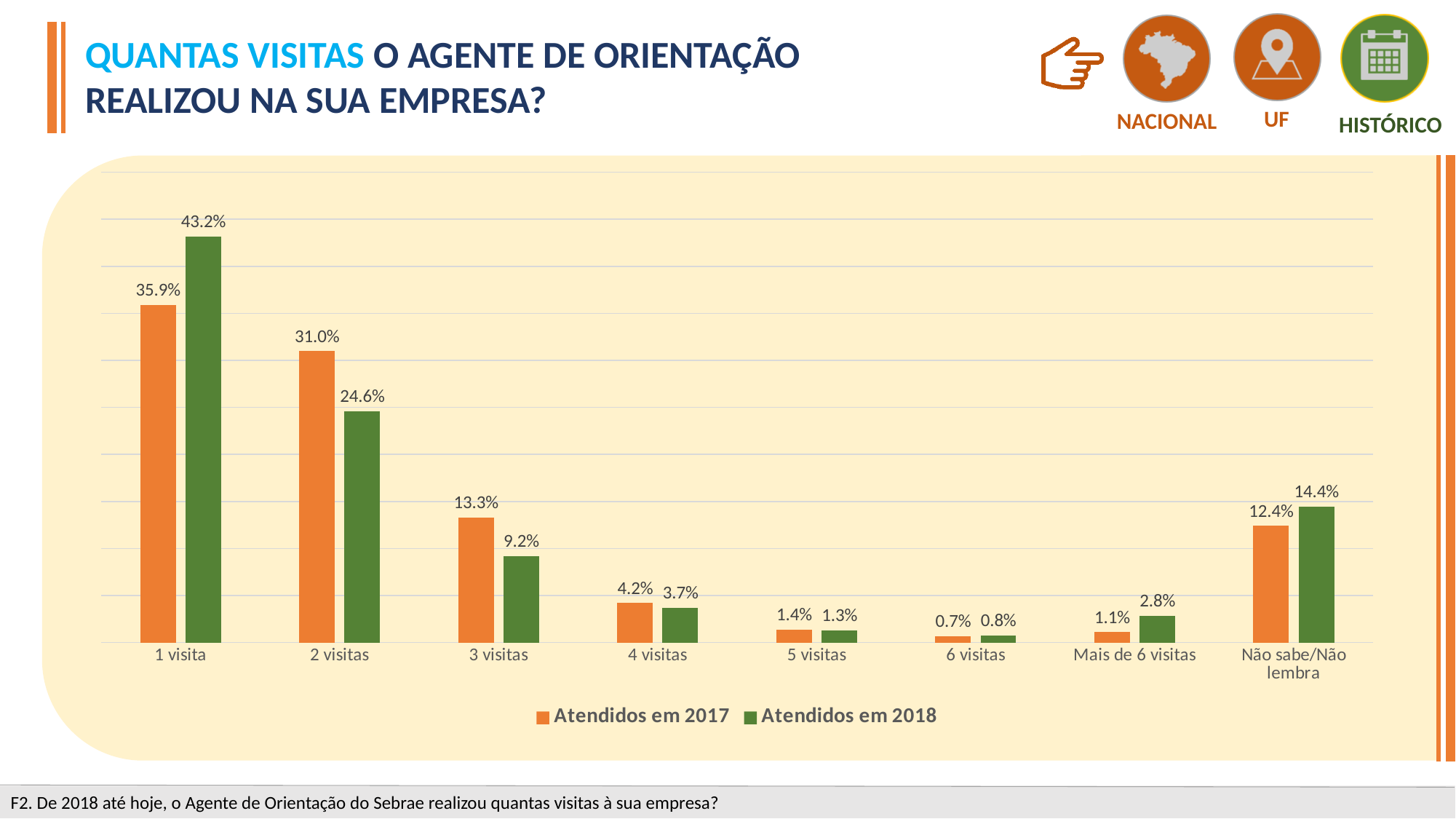
What is the value for 'Mais de 6 visitas' in the 'Atendidos em 2018' series? 2.8% What is the difference between the 'Atendidos em 2018' and 'Atendidos em 2017' values for '1 visita'? 7.3% Which category has the highest value in the 'Atendidos em 2017' series? 1 visita What is the value for '1 visita' in the 'Atendidos em 2018' series? 43.2% How many series does the legend list? 2 Which category has the lowest value in the 'Atendidos em 2017' series? 6 visitas What is the value for '2 visitas' in the 'Atendidos em 2017' series? 31.0% For '2 visitas', which series has the larger value, 'Atendidos em 2017' or 'Atendidos em 2018'? Atendidos em 2017 Which colour represents the 'Atendidos em 2018' series? Green What kind of chart is shown on the slide? Bar chart What is the value for 'Não sabe/Não lembra' in the 'Atendidos em 2018' series? 14.4% How many categories are shown on the x axis? 8